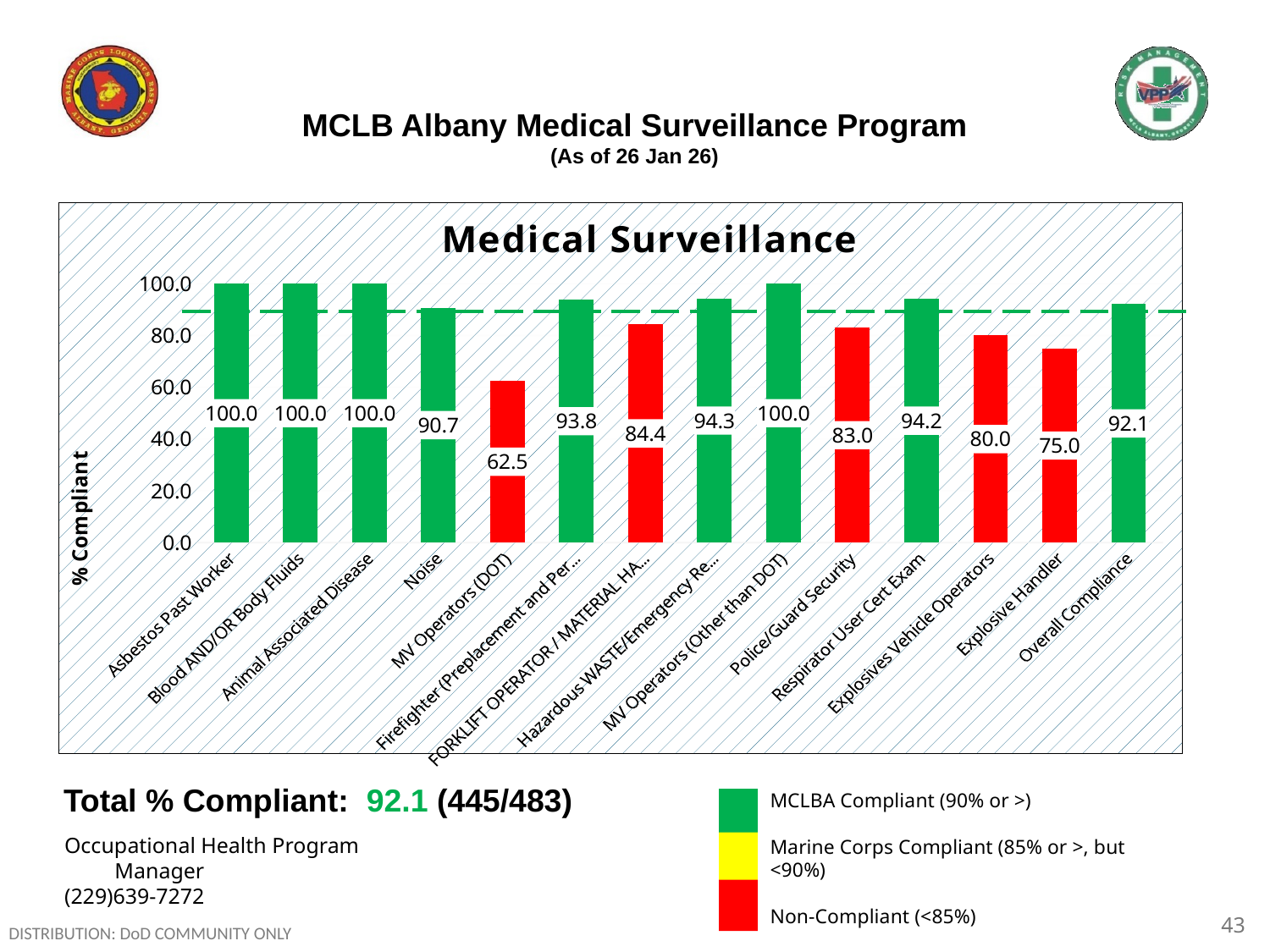
What is the value for Police/Guard Security in the Medical Surveillance chart? 83.0 What is the value for Overall Compliance in the Medical Surveillance chart? 92.1 How many categories are shown in the Medical Surveillance chart? 14 Is the value for Explosives Vehicle Operators in the Medical Surveillance chart greater or less than 60.0? greater Which category has the lowest value in the Medical Surveillance chart? MV Operators (DOT) What is the value for MV Operators (DOT) in the Medical Surveillance chart? 62.5 What is the value for Noise in the Medical Surveillance chart? 90.7 What is the y-axis label of the Medical Surveillance chart? % Compliant What kind of chart is the Medical Surveillance chart? bar chart Which is larger in the Medical Surveillance chart, the value for Noise or the value for Police/Guard Security? Noise What is the difference between the values for Respirator User Cert Exam and Explosives Vehicle Operators in the Medical Surveillance chart? 14.2 What is the value for Explosive Handler in the Medical Surveillance chart? 75.0